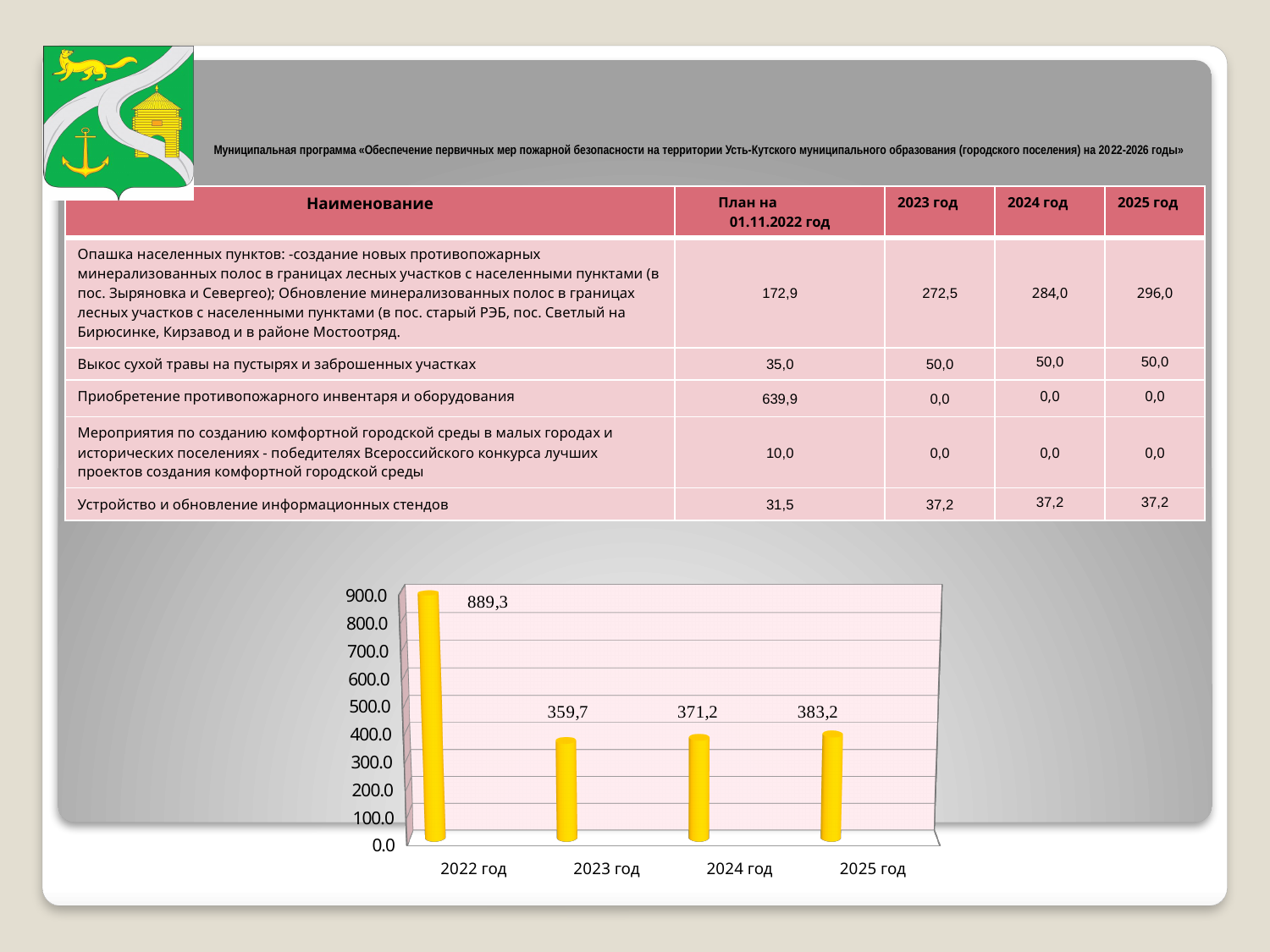
Which is larger, the value for 2024 год or the value for 2025 год? 2025 год What is the difference between the values for 2022 год and 2023 год? 529,6 Which year has the lowest value in the chart? 2023 год Which year has the highest value in the chart? 2022 год What is the difference between the values for 2025 год and 2024 год? 12,0 What is the value shown for 2023 год? 359,7 What is the value shown for 2024 год? 371,2 Is the value for 2023 год greater or less than 400.0? less What is the value shown for 2022 год? 889,3 What kind of chart is shown on the slide? bar chart How many years are shown on the x axis of the chart? 4 What is the value shown for 2025 год? 383,2